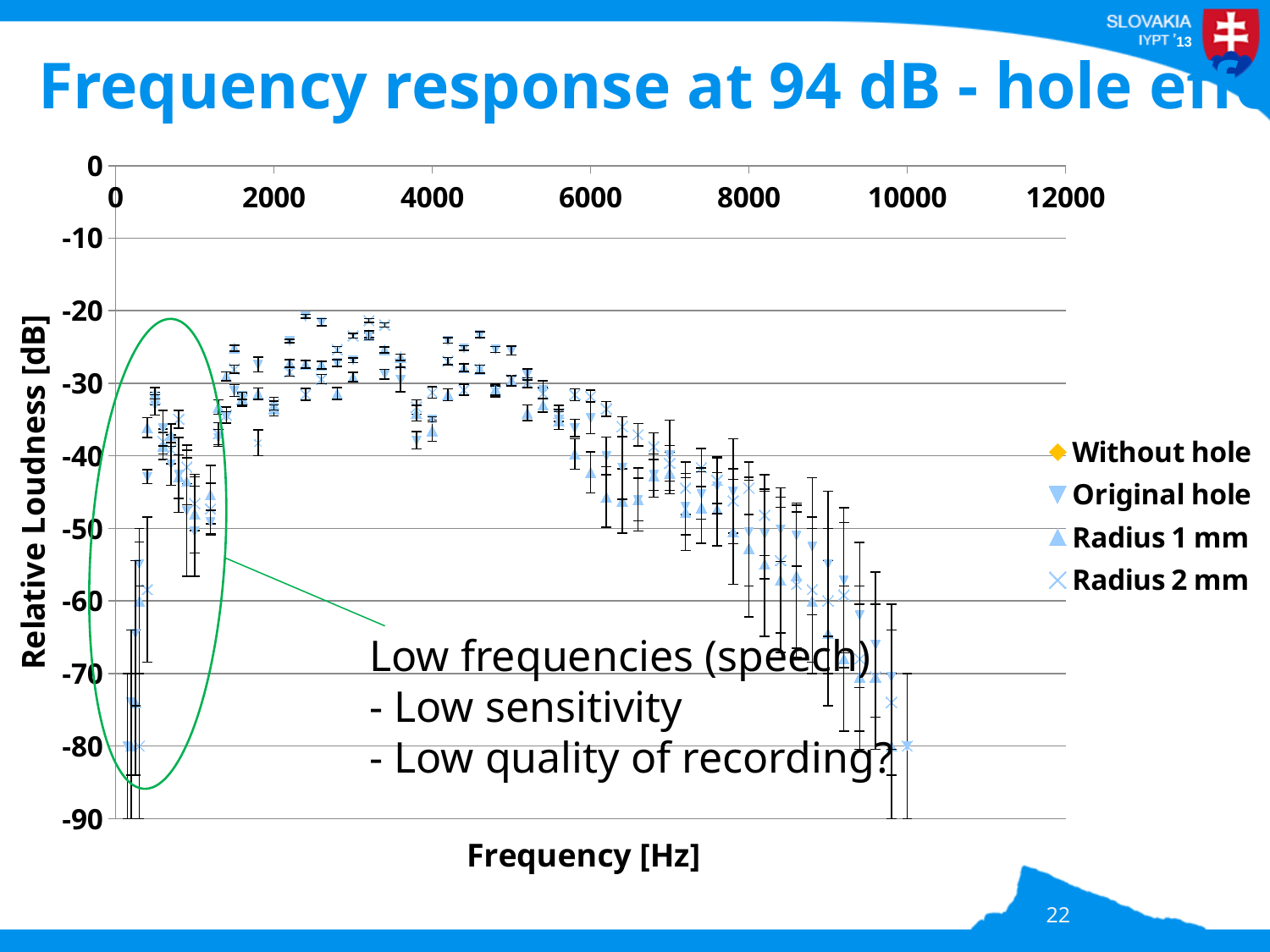
How many series does the legend list? 4 What are the four series listed in the legend? Without hole, Original hole, Radius 1 mm, Radius 2 mm What is the highest tick value shown on the horizontal axis? 12000 What is the lowest tick value shown on the vertical axis? -90 Are the plotted values near 10000 Hz greater or less than -60 dB? less What kind of chart is shown on the slide? Scatter chart Are the plotted values near 2400 Hz greater or less than -30 dB? greater Do the plotted values rise or fall as frequency increases from 4000 Hz to 10000 Hz? fall Are the plotted values between 2000 Hz and 4000 Hz greater or less than -40 dB? greater